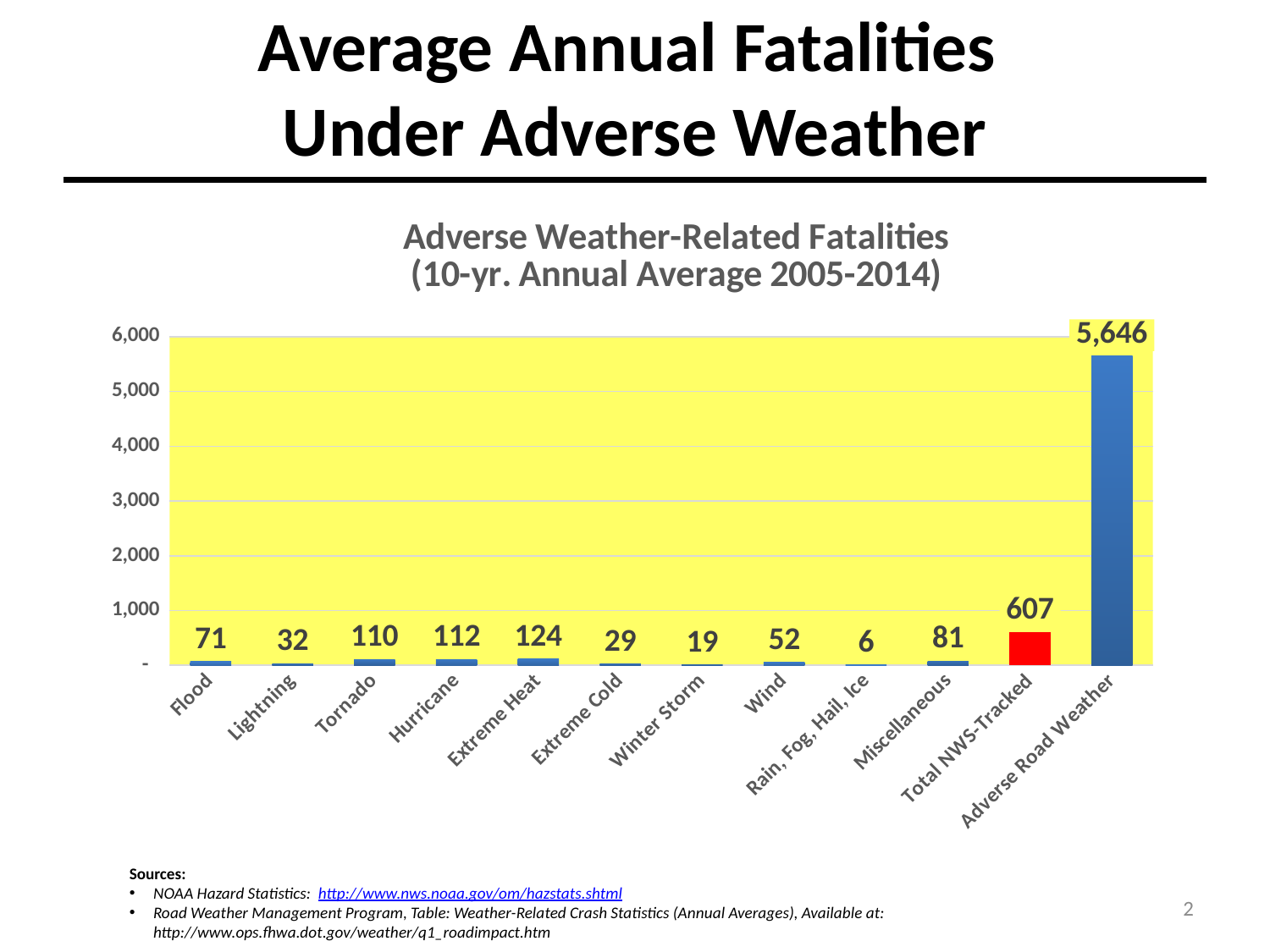
What is the value for Adverse Road Weather? 5,646 What is the value for Total NWS-Tracked? 607 What kind of chart is this? Bar chart Which category has the lowest value? Rain, Fog, Hail, Ice What is the difference between Hurricane and Tornado? 2 Which is larger, Flood or Wind? Flood Which category has the highest value? Adverse Road Weather How many categories are shown on the x axis? 12 What is the value for Extreme Heat? 124 What is the title of the chart? Adverse Weather-Related Fatalities (10-yr. Annual Average 2005-2014) What is the value for Rain, Fog, Hail, Ice? 6 What is the difference between Adverse Road Weather and Total NWS-Tracked? 5,039